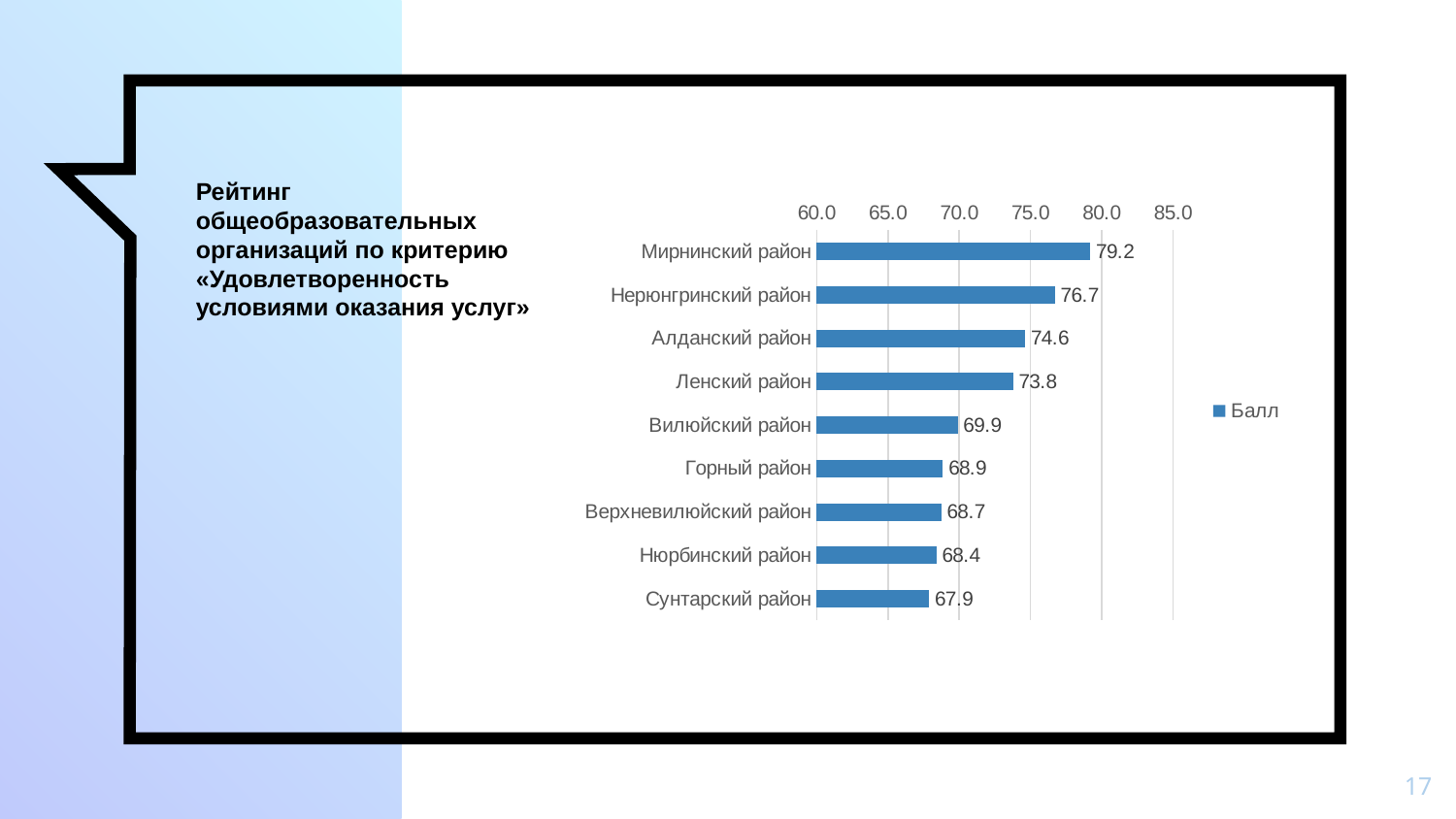
What is the value for Мирнинский район? 79.2 What is the name of the series in the legend? Балл What is the value for Вилюйский район? 69.9 What is the value for Сунтарский район? 67.9 How many series does the legend list? 1 Which district has the highest value? Мирнинский район How many districts are shown in the chart? 9 Which district has the lowest value? Сунтарский район What is the difference between the values for Мирнинский район and Нерюнгринский район? 2.5 Which is larger, the value for Алданский район or the value for Ленский район? Алданский район Is the value for Нерюнгринский район greater or less than 75.0? greater What kind of chart is shown on the slide? bar chart